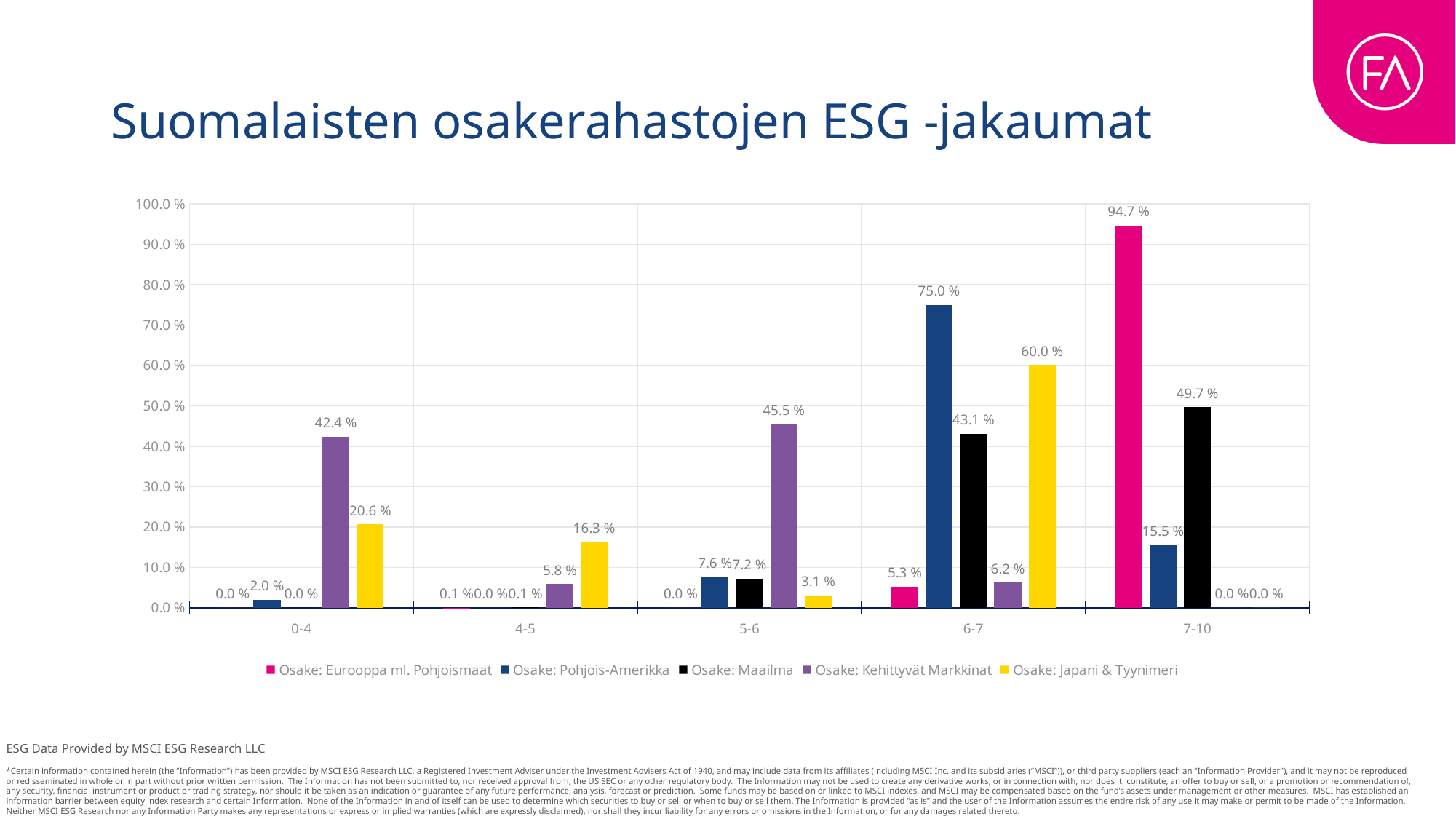
What is the difference between Osake: Pohjois-Amerikka and Osake: Maailma in the 6-7 category? 31.9 % What is the value for Osake: Kehittyvät Markkinat in the 5-6 category? 45.5 % What is the title of the chart? Suomalaisten osakerahastojen ESG -jakaumat How many series does the legend list? 5 In which category does Osake: Japani & Tyynimeri have its lowest value? 7-10 What is the value for Osake: Japani & Tyynimeri in the 6-7 category? 60.0 % Which is larger in the 0-4 category: Osake: Kehittyvät Markkinat or Osake: Japani & Tyynimeri? Osake: Kehittyvät Markkinat How many categories are shown on the x axis? 5 What is the value for Osake: Maailma in the 7-10 category? 49.7 % What type of chart is shown on the slide? bar chart In which category does Osake: Pohjois-Amerikka have its highest value? 6-7 What is the value for Osake: Eurooppa ml. Pohjoismaat in the 7-10 category? 94.7 %